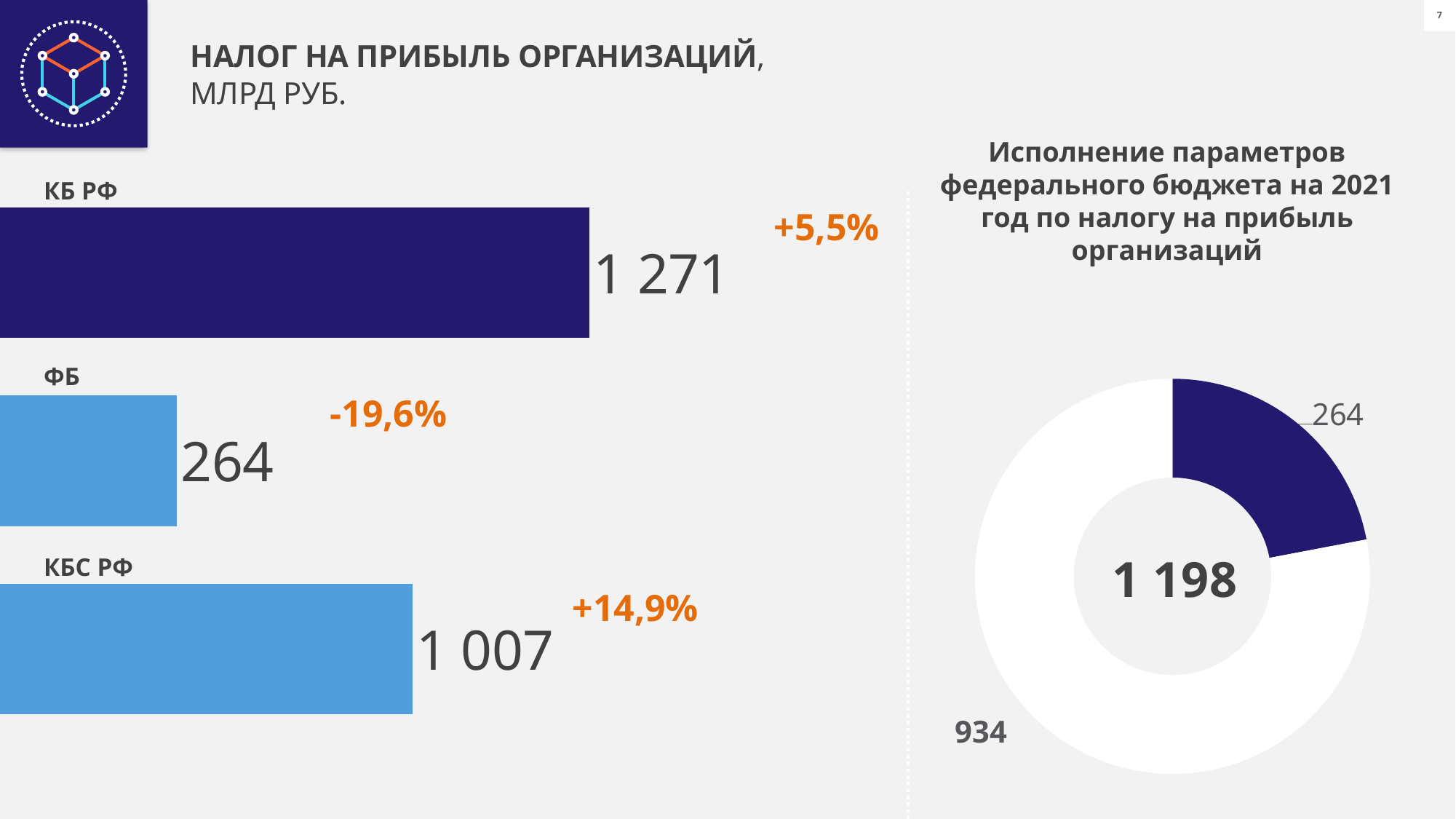
On the bar chart on the left, what percentage change is shown next to ФБ? -19,6% On the donut chart on the right, what total is shown in the centre? 1 198 On the bar chart on the left, what is the value for ФБ? 264 On the bar chart on the left, which is larger, the value for КБС РФ or the value for ФБ? КБС РФ On the bar chart on the left, what is the difference between the values for КБ РФ and КБС РФ? 264 On the donut chart on the right, what is the value of the dark blue slice? 264 On the bar chart on the left, how many bars are shown? 3 On the bar chart on the left, which category has the lowest value? ФБ What kind of chart is shown on the left of the slide? Bar chart On the bar chart on the left, what is the value for КБС РФ? 1 007 On the bar chart on the left, which category has the highest value? КБ РФ On the bar chart on the left, what is the value for КБ РФ? 1 271